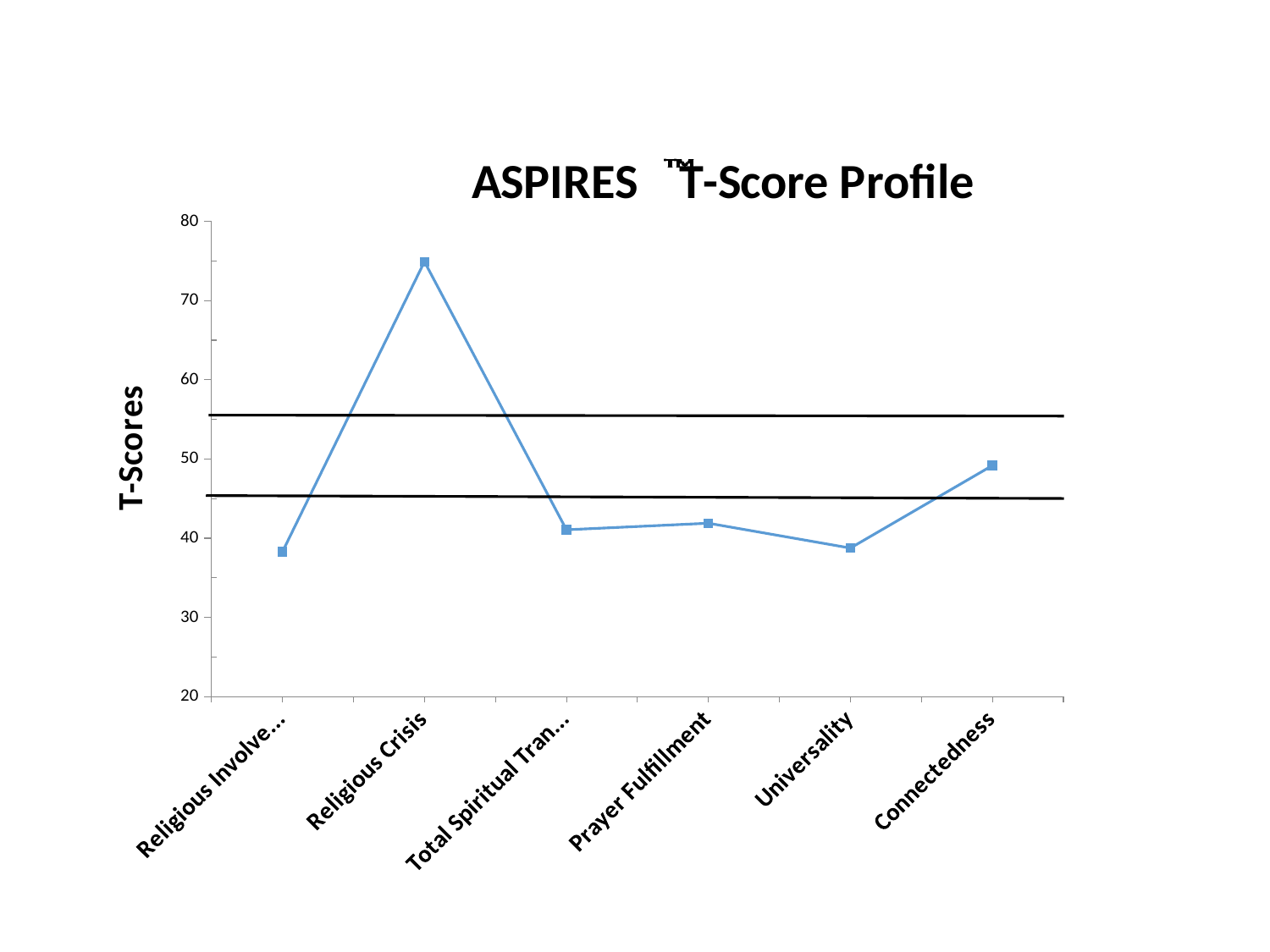
Is the value for Prayer Fulfillment greater or less than 50? less Is the value for Religious Crisis greater or less than 70? greater Which category has the highest T-score? Religious Crisis How many categories are plotted along the x axis? 6 Is the value for Connectedness greater or less than 40? greater Does the line rise or fall from Universality to Connectedness? rise How many horizontal black reference lines are drawn across the chart? 2 What is the label on the y axis? T-Scores What kind of chart is shown on the slide? line chart Which is larger, the value for Religious Crisis or the value for Prayer Fulfillment? Religious Crisis Which is larger, the value for Connectedness or the value for Universality? Connectedness